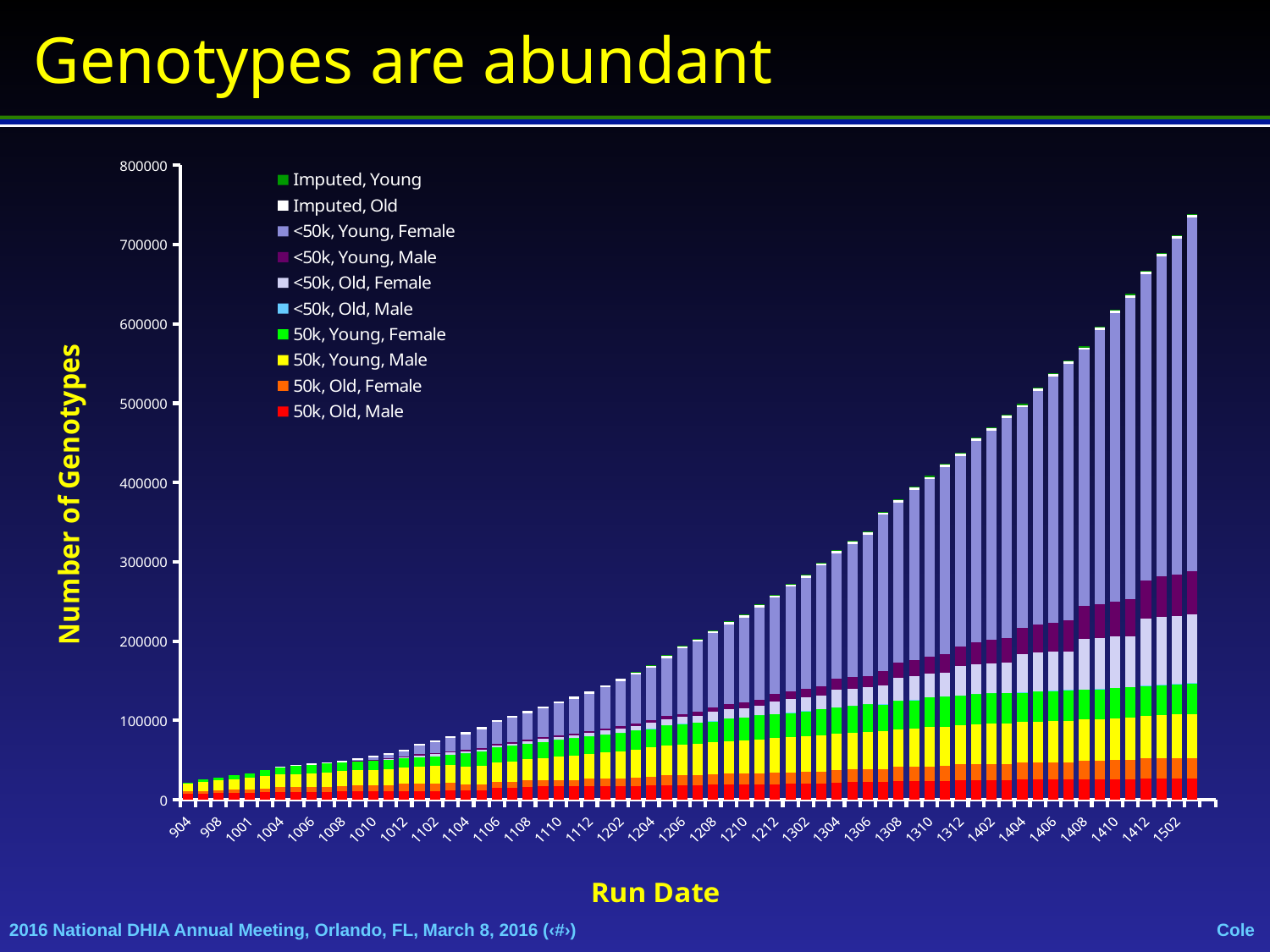
How many series does the legend list? 10 Do the total number of genotypes rise or fall as the run date increases? Rise What kind of chart is shown on the slide? Stacked bar chart Which run date has the lowest total number of genotypes? 904 What is the title of the chart? Genotypes are abundant Is the total number of genotypes for run date 904 greater or less than 100000? less Which has a larger total number of genotypes, run date 1302 or run date 1102? 1302 Is the total number of genotypes for run date 1402 greater or less than 400000? greater What is the label of the y axis? Number of Genotypes